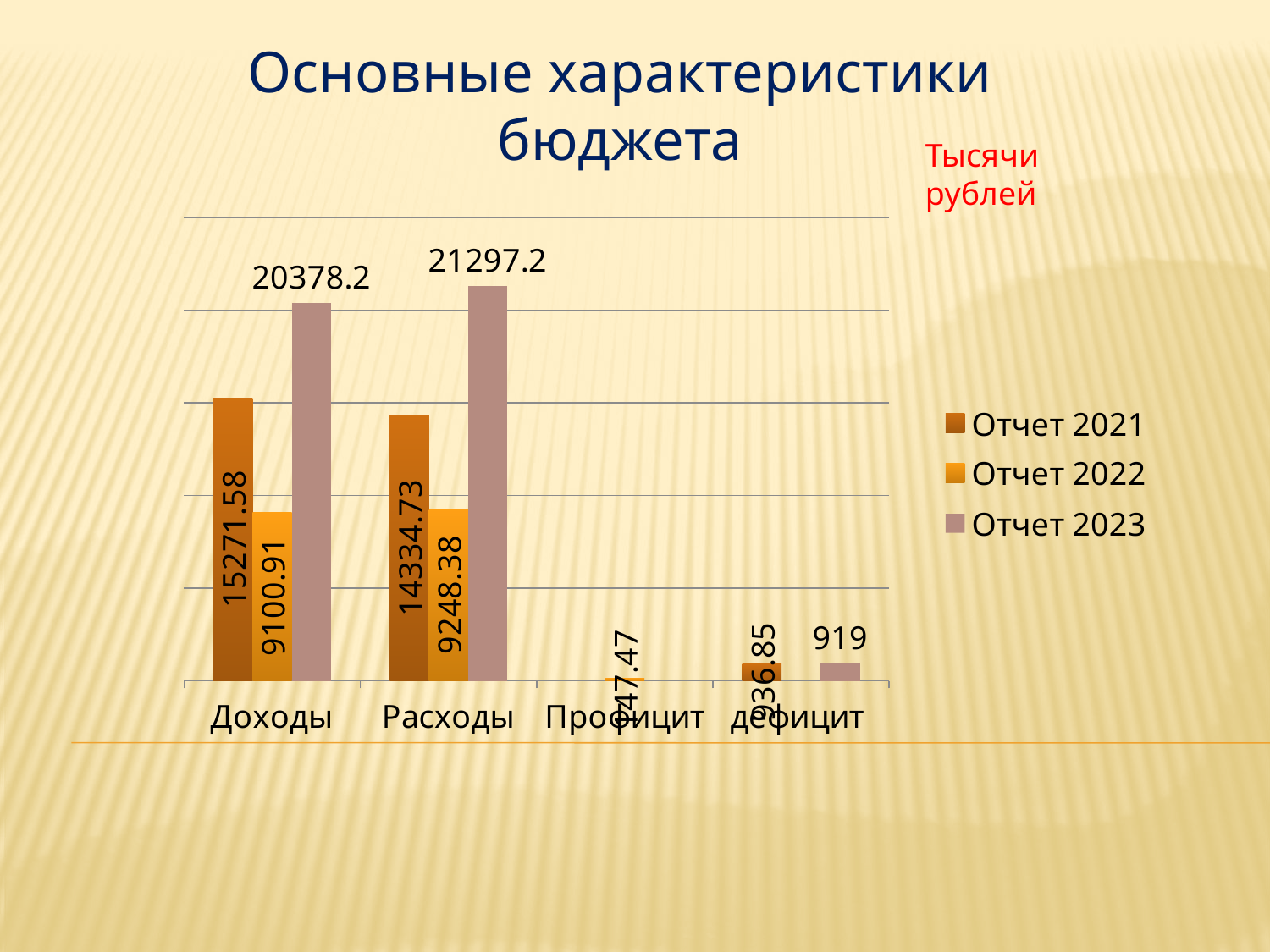
How many series does the legend list? 3 What is the value for Расходы in the Отчет 2022 series? 9248.38 What is the value for Доходы in the Отчет 2023 series? 20378.2 What is the difference between the Отчет 2023 values for Расходы and Доходы? 919 Which category has the highest value in the Отчет 2023 series? Расходы What is the value for Расходы in the Отчет 2023 series? 21297.2 How many categories are shown on the x axis? 4 Which is larger for Доходы: the Отчет 2021 value or the Отчет 2022 value? Отчет 2021 What type of chart is shown on the slide? bar chart What is the value for Доходы in the Отчет 2022 series? 9100.91 What unit is indicated in red text next to the chart? Тысячи рублей What is the value for Доходы in the Отчет 2021 series? 15271.58